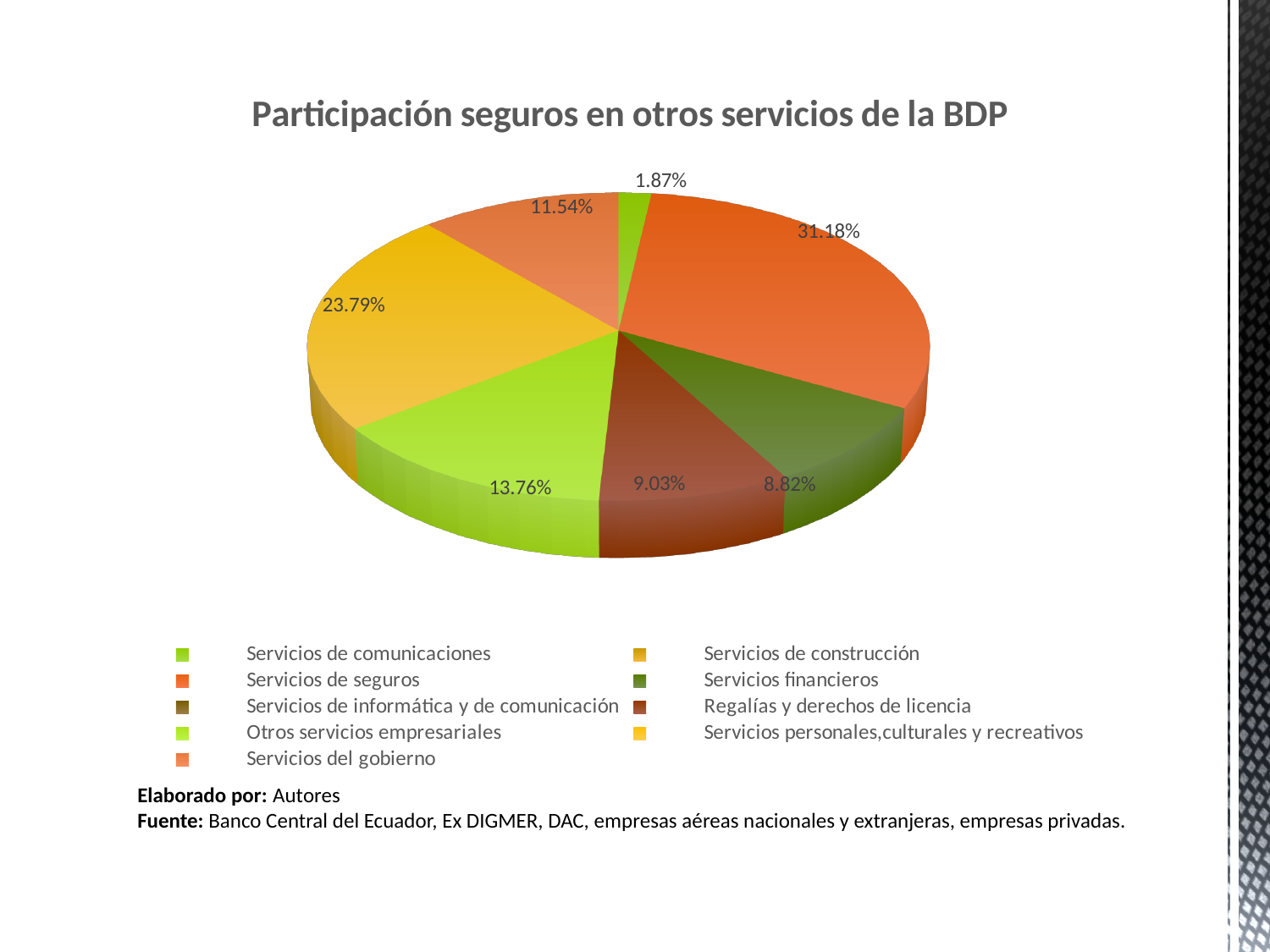
What kind of chart is shown on the slide? pie chart How many entries does the chart legend list? 9 What is the smallest percentage labelled on the pie? 1.87% What share of the pie does Servicios financieros represent? 8.82% What is the title of the chart? Participación seguros en otros servicios de la BDP What share of the pie does Servicios del gobierno represent? 11.54% What share of the pie does the largest slice (Servicios de seguros) represent? 31.18% Which is larger, the slice labelled 23.79% or the slice labelled 13.76%? the slice labelled 23.79% How many slices of the pie have a percentage label printed on the chart? 7 What is the difference between the 31.18% slice and the 23.79% slice? 7.39% Which slice has the largest share of the pie? Servicios de seguros